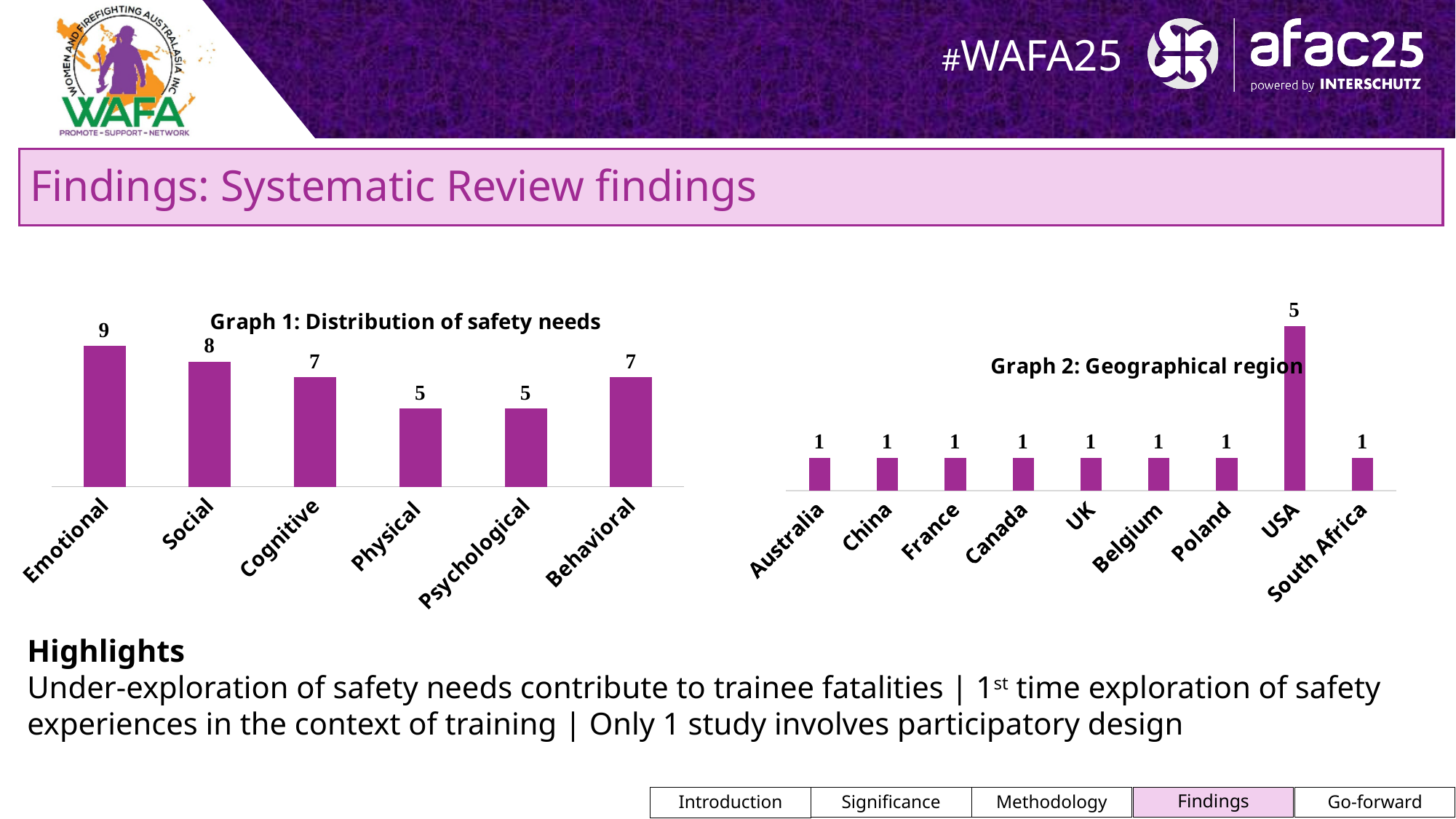
What kind of chart is Graph 2: Geographical region? Bar chart In Graph 1: Distribution of safety needs, which is larger, Cognitive or Psychological? Cognitive In Graph 1: Distribution of safety needs, which category has the highest value? Emotional In Graph 1: Distribution of safety needs, how many categories are shown? 6 What is the title of the chart on the left of the slide? Graph 1: Distribution of safety needs In Graph 1: Distribution of safety needs, what is the difference between Emotional and Physical? 4 In Graph 1: Distribution of safety needs, what is the value for Emotional? 9 In Graph 2: Geographical region, what is the difference between USA and Australia? 4 In Graph 2: Geographical region, which region has the highest value? USA In Graph 2: Geographical region, how many regions are shown? 9 In Graph 2: Geographical region, what is the value for USA? 5 In Graph 1: Distribution of safety needs, what is the value for Social? 8